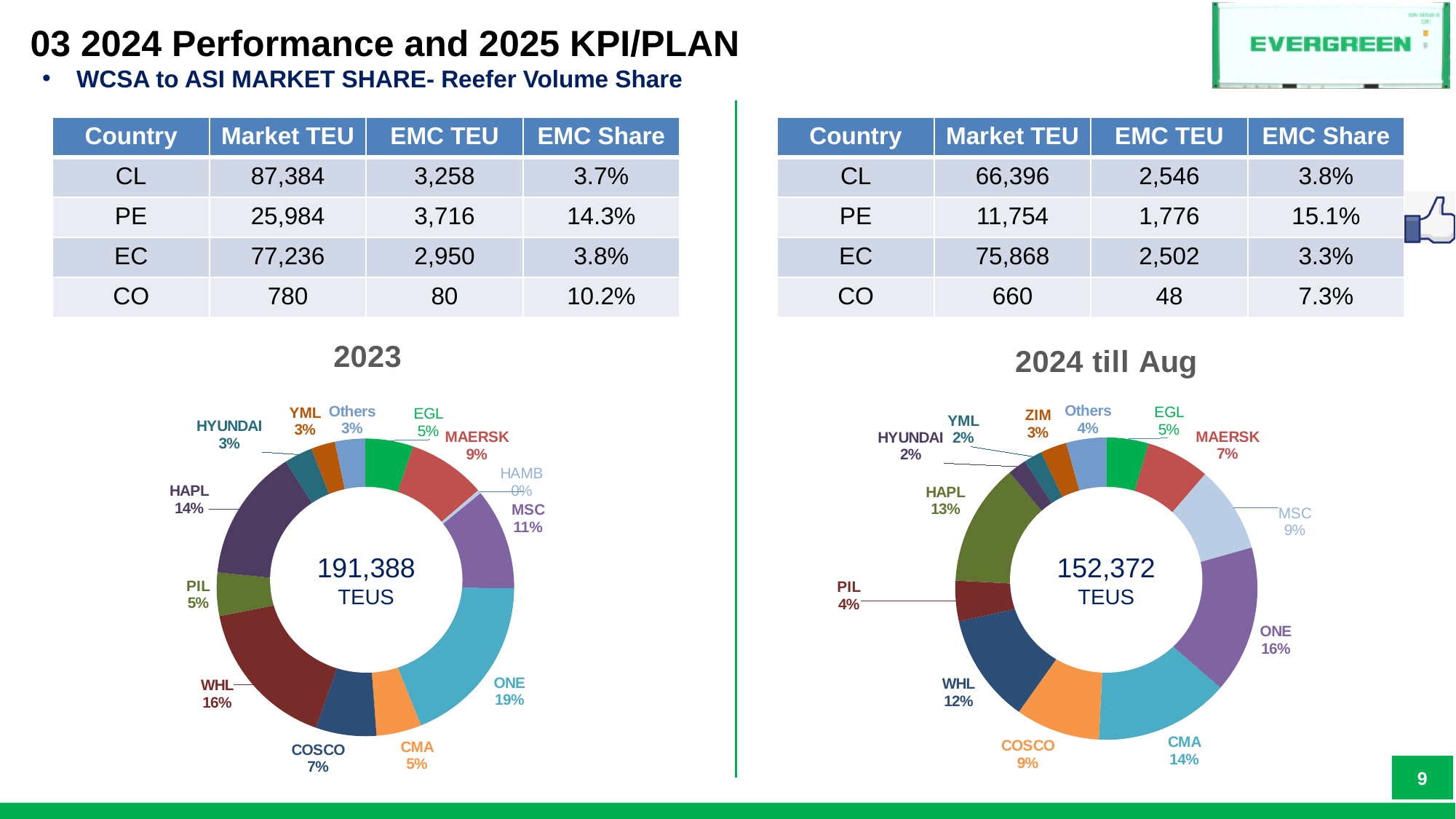
In the 2023 chart, which carrier has the smallest share? HAMB In the 2023 chart, what share does ONE hold? 19% In the 2023 chart, which carrier has the largest share? ONE In the 2024 till Aug chart, what share does CMA hold? 14% In the 2023 chart, which is larger, the share of WHL or the share of HAPL? WHL In the 2024 till Aug chart, what is the difference between WHL's share and PIL's share? 8% In the 2024 till Aug chart, which is larger, the share of MAERSK or the share of MSC? MSC What total volume is shown in the centre of the 2024 till Aug chart? 152,372 TEUS What total volume is shown in the centre of the 2023 chart? 191,388 TEUS In the 2024 till Aug chart, which carrier has the largest share? ONE How many slices does the 2023 chart have? 13 What kind of chart is the 2024 till Aug chart? Donut (pie) chart